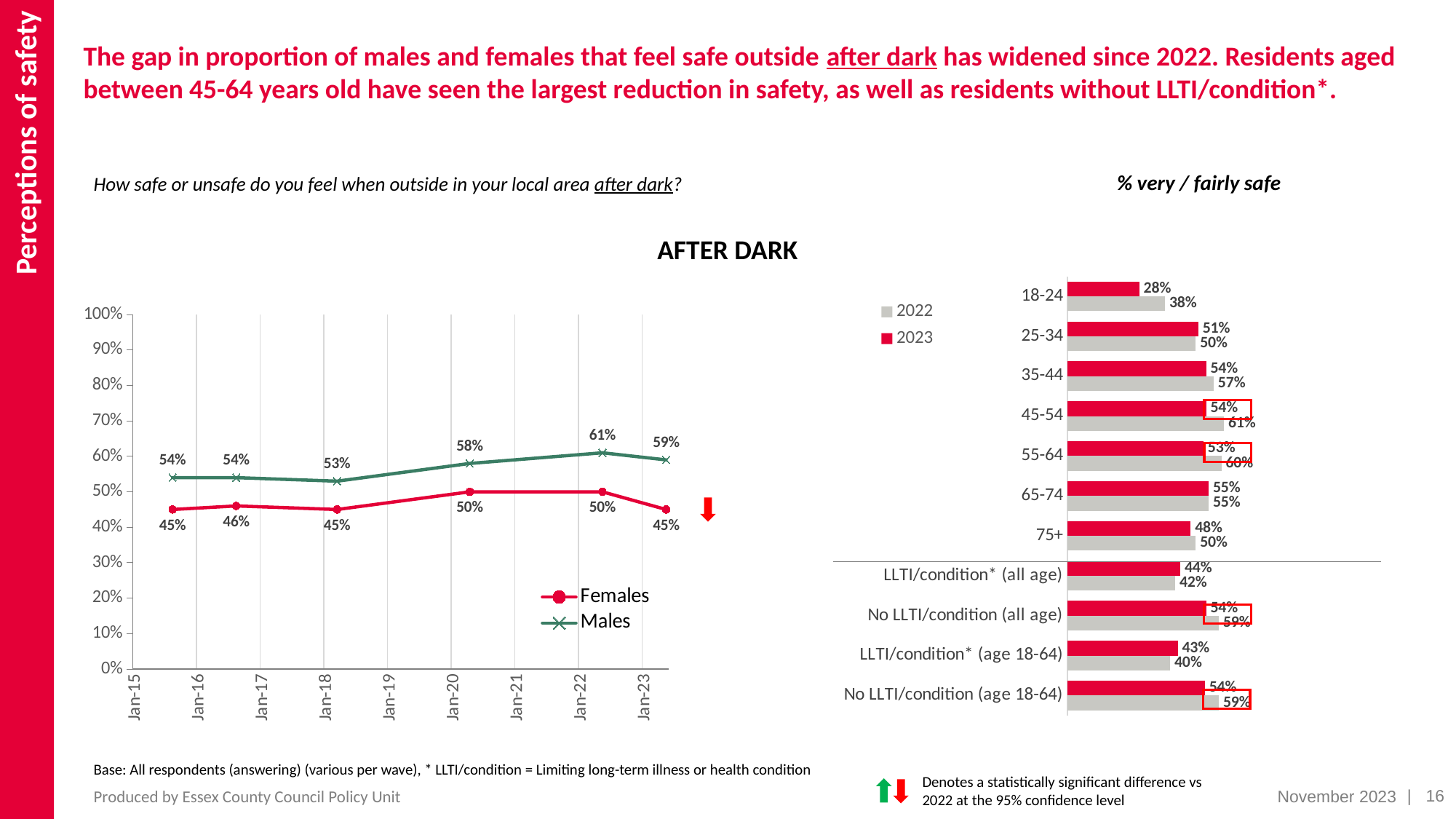
On the bar chart on the right, which age group has the lowest 2023 value? 18-24 On the AFTER DARK line chart, what is the highest value reached by the Males line? 61% On the AFTER DARK line chart, what is the difference between the latest Males value and the latest Females value? 14 percentage points What type of chart is the AFTER DARK chart on the left? Line chart On the bar chart on the right, what is the difference between the 2022 and 2023 values for the 18-24 age group? 10 percentage points On the bar chart on the right, how many categories are shown? 11 On the bar chart on the right, what is the 2022 value for the 45-54 age group? 61% On the AFTER DARK line chart, how many series does the legend list? 2 On the AFTER DARK line chart, what is the latest (rightmost) value for Females? 45% On the bar chart on the right, what is the 2023 value for the 18-24 age group? 28% On the bar chart on the right, is the 2023 value for LLTI/condition* (all age) larger or smaller than its 2022 value? Larger On the AFTER DARK line chart, what is the latest (rightmost) value for Males? 59%